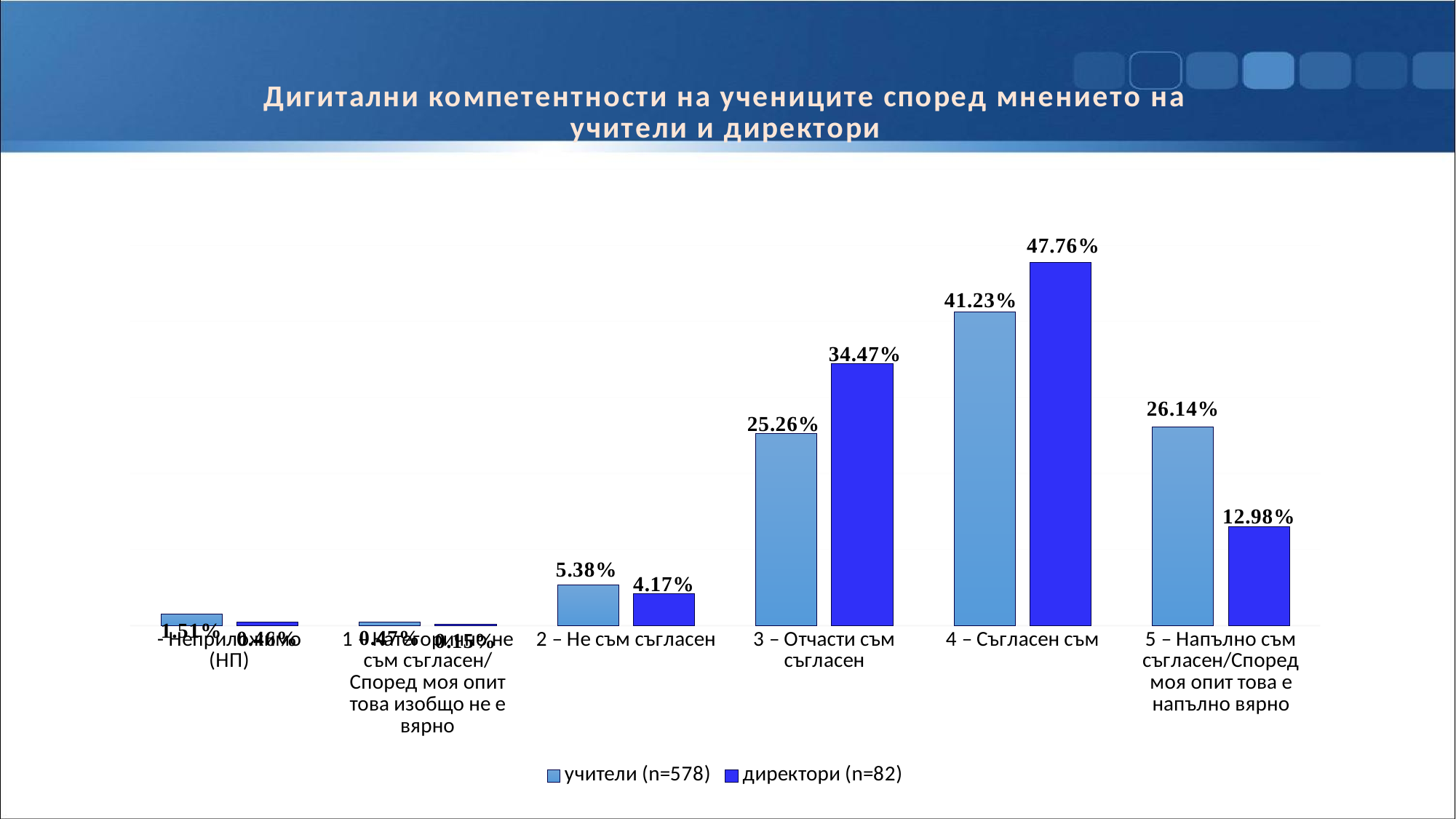
What is the value for учители (n=578) in the category "4 – Съгласен съм"? 41.23% What is the title of the chart on the slide? Дигитални компетентности на учениците според мнението на учители и директори What is the value for директори (n=82) in the category "3 – Отчасти съм съгласен"? 34.47% How many categories are shown on the x axis? 6 What type of chart is shown on the slide? bar chart Which series has the larger value in the category "5 – Напълно съм съгласен/Според моя опит това е напълно вярно"? учители (n=578) What is the difference between учители (n=578) and директори (n=82) in the category "5 – Напълно съм съгласен/Според моя опит това е напълно вярно"? 13.16% What is the difference between директори (n=82) and учители (n=578) in the category "4 – Съгласен съм"? 6.53% What is the value for учители (n=578) in the category "2 – Не съм съгласен"? 5.38% What is the value for директори (n=82) in the category "5 – Напълно съм съгласен/Според моя опит това е напълно вярно"? 12.98% How many series does the legend list? 2 In which category does the директори (n=82) series reach its highest value? 4 – Съгласен съм